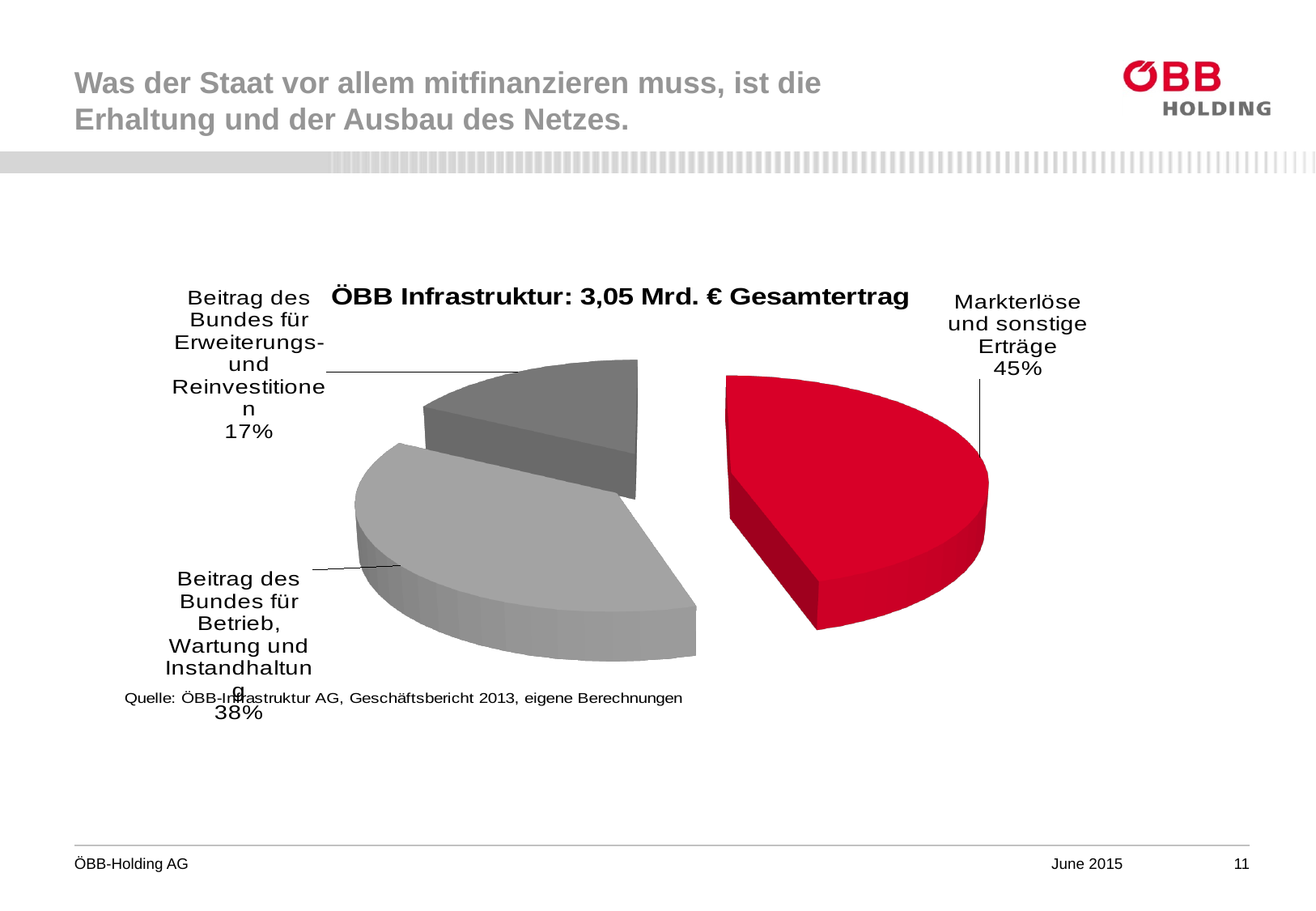
Which slice of the pie is the smallest? Beitrag des Bundes für Erweiterungs- und Reinvestitionen What share of the pie is 'Beitrag des Bundes für Betrieb, Wartung und Instandhaltung'? 38% What is the combined share of the two 'Beitrag des Bundes' slices? 55% Which slice of the pie is the largest? Markterlöse und sonstige Erträge Which slice of the pie is coloured red? Markterlöse und sonstige Erträge How many slices does the pie chart have? 3 What kind of chart is shown on the slide? Pie chart What share of the pie is 'Markterlöse und sonstige Erträge'? 45% What share of the pie is 'Beitrag des Bundes für Erweiterungs- und Reinvestitionen'? 17% What is the difference in percentage points between 'Markterlöse und sonstige Erträge' and 'Beitrag des Bundes für Betrieb, Wartung und Instandhaltung'? 7 percentage points Which is larger: 'Beitrag des Bundes für Betrieb, Wartung und Instandhaltung' or 'Beitrag des Bundes für Erweiterungs- und Reinvestitionen'? Beitrag des Bundes für Betrieb, Wartung und Instandhaltung What is the title of the chart? ÖBB Infrastruktur: 3,05 Mrd. € Gesamtertrag